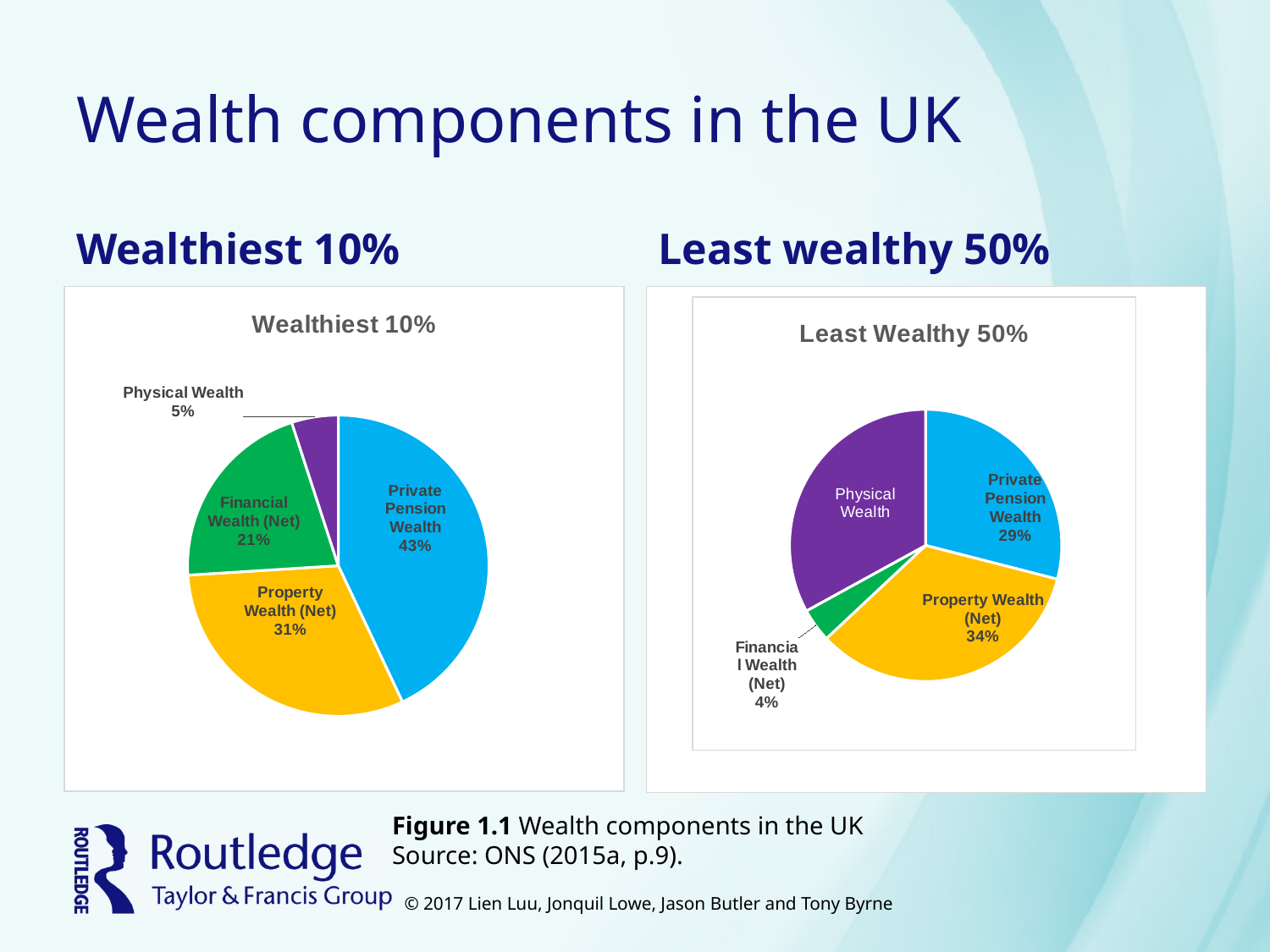
In the Wealthiest 10% chart, what share is Property Wealth (Net)? 31% In the Wealthiest 10% chart, what share is Financial Wealth (Net)? 21% In the Least Wealthy 50% chart, which component has the smallest share? Financial Wealth (Net) In the Wealthiest 10% chart, which component has the largest share? Private Pension Wealth How many slices does the Wealthiest 10% pie chart have? 4 In the Least Wealthy 50% chart, which is larger: Physical Wealth or Financial Wealth (Net)? Physical Wealth In the Least Wealthy 50% chart, what share is Property Wealth (Net)? 34% In the Wealthiest 10% chart, which component has the smallest share? Physical Wealth In the Wealthiest 10% chart, what is the difference between the Private Pension Wealth share and the Property Wealth (Net) share? 12% In the Least Wealthy 50% chart, what share is Private Pension Wealth? 29% What type of chart is used for the Least Wealthy 50% data? Pie chart In the Wealthiest 10% chart, what share is Private Pension Wealth? 43%